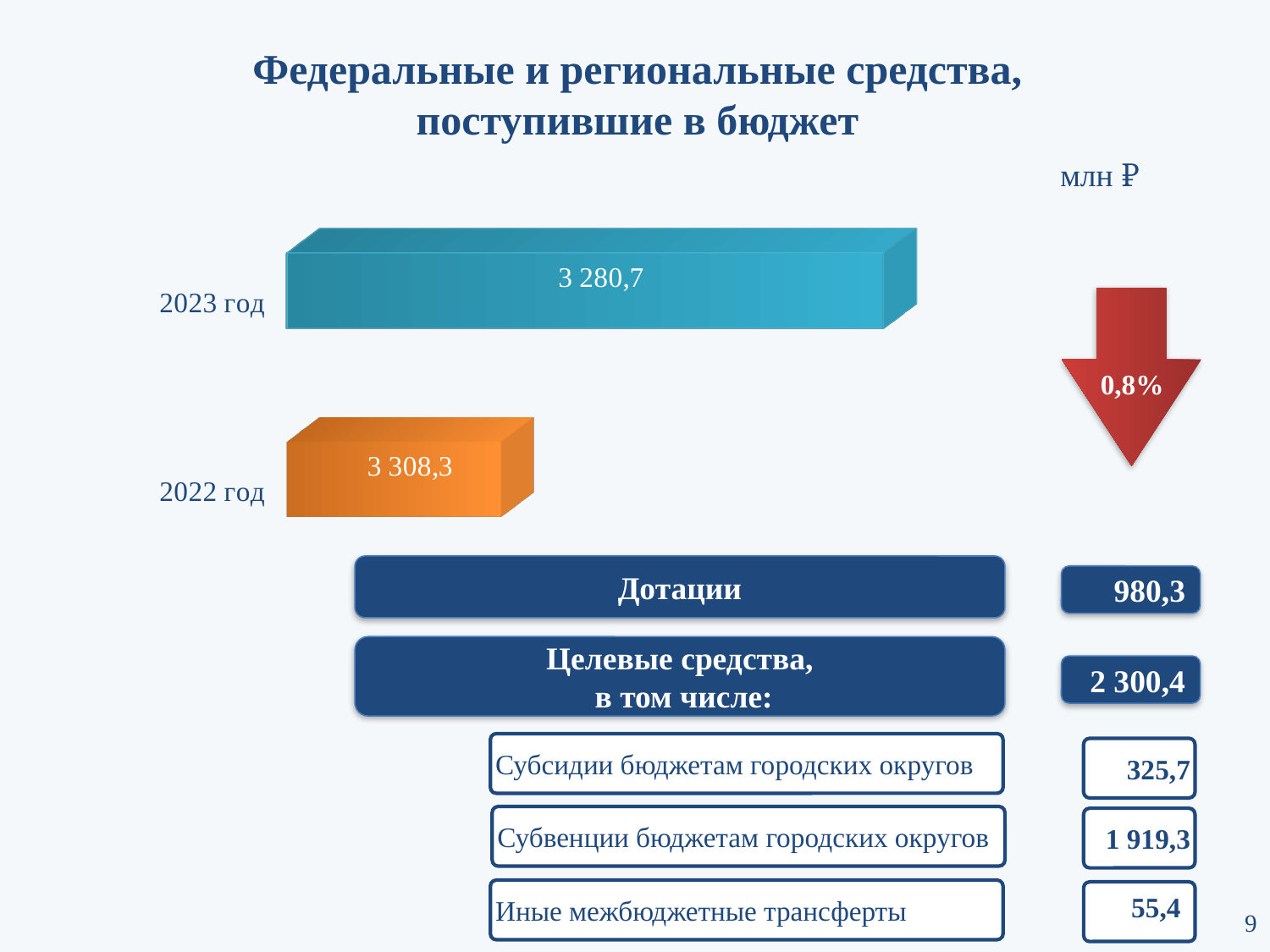
What is the difference between the values for 2022 год and 2023 год? 27,6 How many years (bars) are shown in the chart? 2 What is the value for 2022 год? 3 308,3 Is the value for 2023 год greater or less than 3 300? less Which year has the lowest value according to the data labels? 2023 год What kind of chart is shown on the slide? bar chart Which year has the highest value according to the data labels? 2022 год What is the value for 2023 год? 3 280,7 What percentage change is shown next to the red arrow? 0,8% What unit is indicated for the chart values? млн ₽ Which year has the higher value according to the data labels, 2022 год or 2023 год? 2022 год